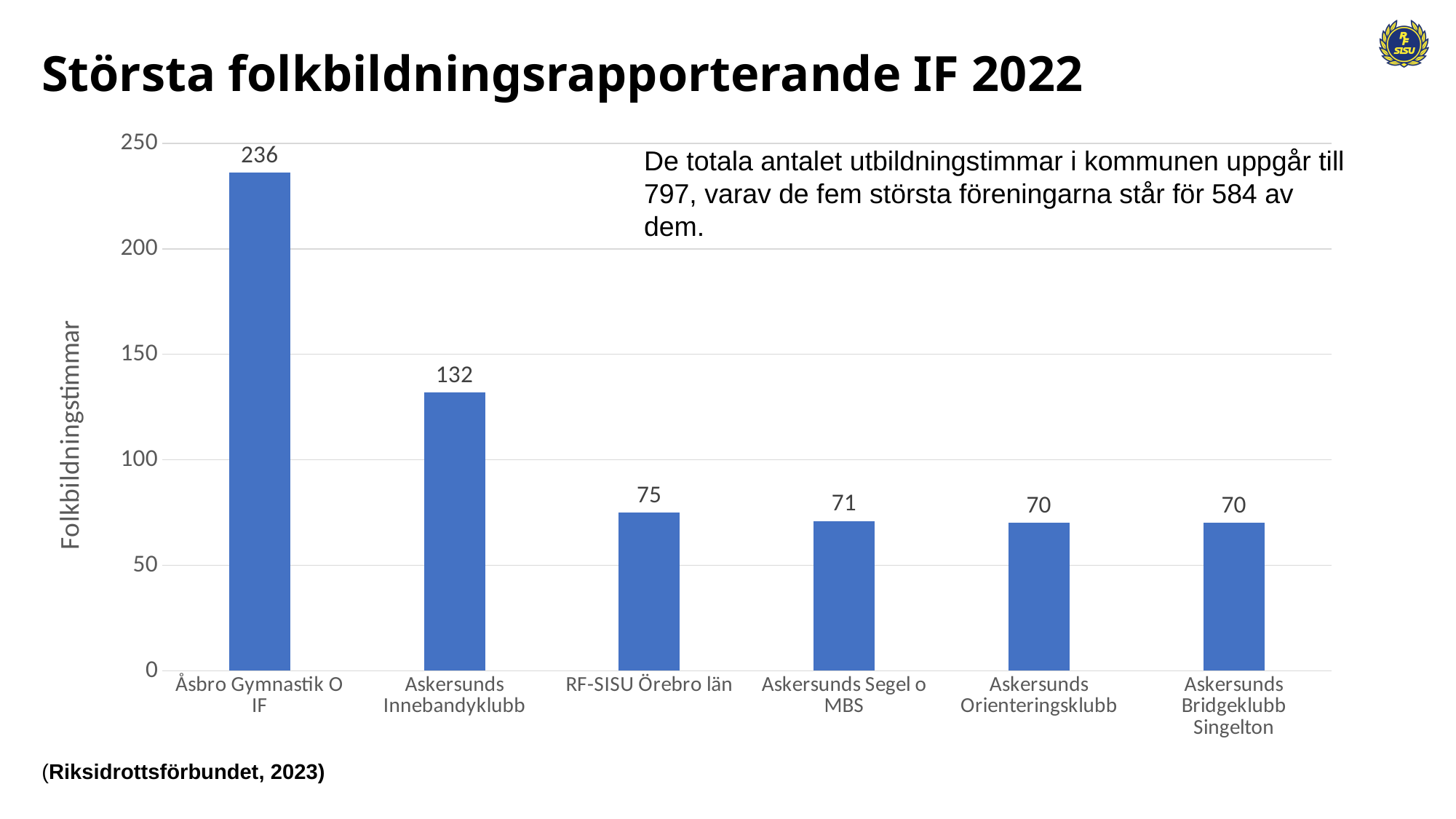
What kind of chart is shown on the slide? bar chart What is the label on the vertical axis of the chart? Folkbildningstimmar Which is larger, the value for Askersunds Innebandyklubb or the value for RF-SISU Örebro län? Askersunds Innebandyklubb Is the value for Askersunds Bridgeklubb Singelton greater or less than 100? less How many categories are shown in the chart? 6 What is the difference between the values for Åsbro Gymnastik O IF and Askersunds Innebandyklubb? 104 What is the value for Åsbro Gymnastik O IF? 236 What is the value for Askersunds Segel o MBS? 71 Which category has the highest value? Åsbro Gymnastik O IF What is the value for Askersunds Innebandyklubb? 132 What is the difference between the values for RF-SISU Örebro län and Askersunds Orienteringsklubb? 5 What is the value for RF-SISU Örebro län? 75